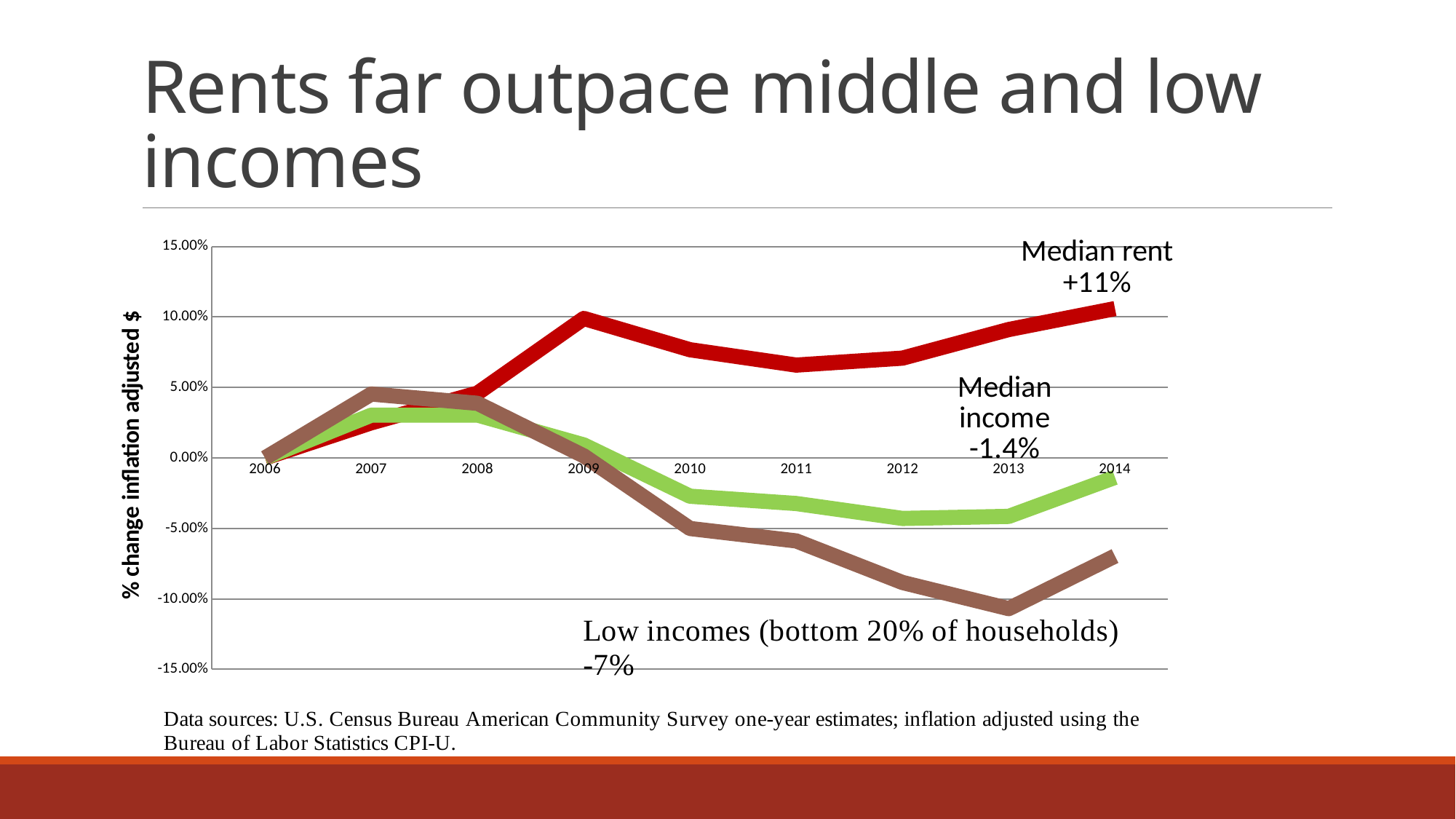
What is the labelled 2014 value for Median rent? +11% What is the labelled 2014 value for Low incomes (bottom 20% of households)? -7% Which series has the lowest value in 2014? Low incomes (bottom 20% of households) How many series (lines) are plotted on the chart? 3 Which series has the highest value in 2014? Median rent How many years are shown on the x axis? 9 What kind of chart is shown on the slide? line chart Is the value for Median rent in 2009 greater or less than 5.00%? greater Does the Median rent line rise or fall from 2011 to 2014? rise What is the labelled 2014 value for Median income? -1.4% What is the difference between the labelled 2014 values for Median rent (+11%) and Low incomes (-7%)? 18 percentage points Is the value for Low incomes (bottom 20% of households) in 2012 greater or less than -5.00%? less